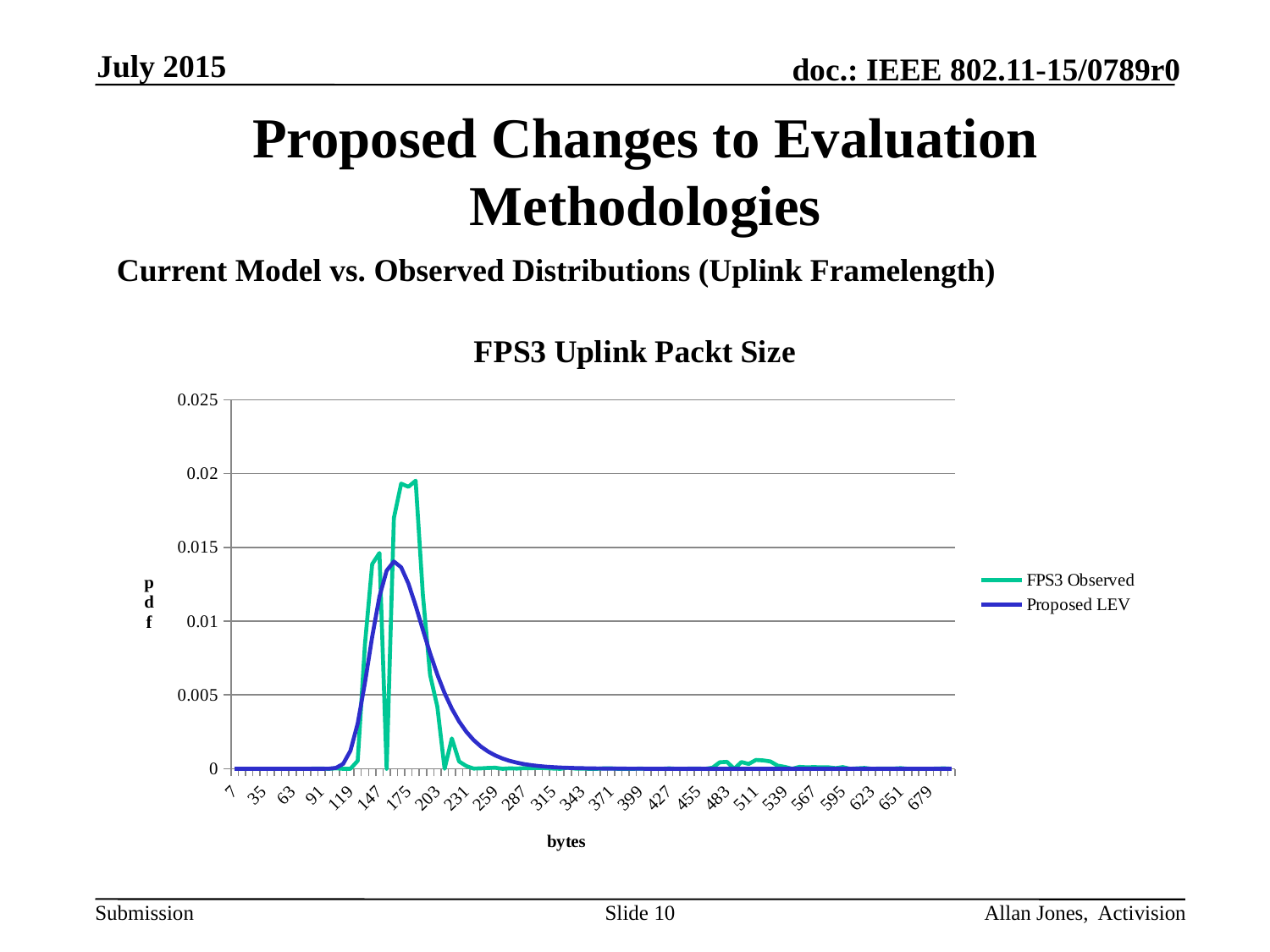
Is the value of the FPS3 Observed series at 63 bytes greater or less than 0.005? less What kind of chart is shown on the slide? Line chart Is the peak value of the Proposed LEV series greater or less than 0.01? greater How many series does the legend of the chart list? 2 What is the highest tick value shown on the y axis of the chart? 0.025 Which series reaches the higher peak value, FPS3 Observed or Proposed LEV? FPS3 Observed Is the value of the Proposed LEV series at 399 bytes greater or less than 0.005? less Do the values of the Proposed LEV series rise or fall between 175 bytes and 259 bytes? fall What is the label of the x axis of the chart? bytes What is the title of the chart? FPS3 Uplink Packt Size